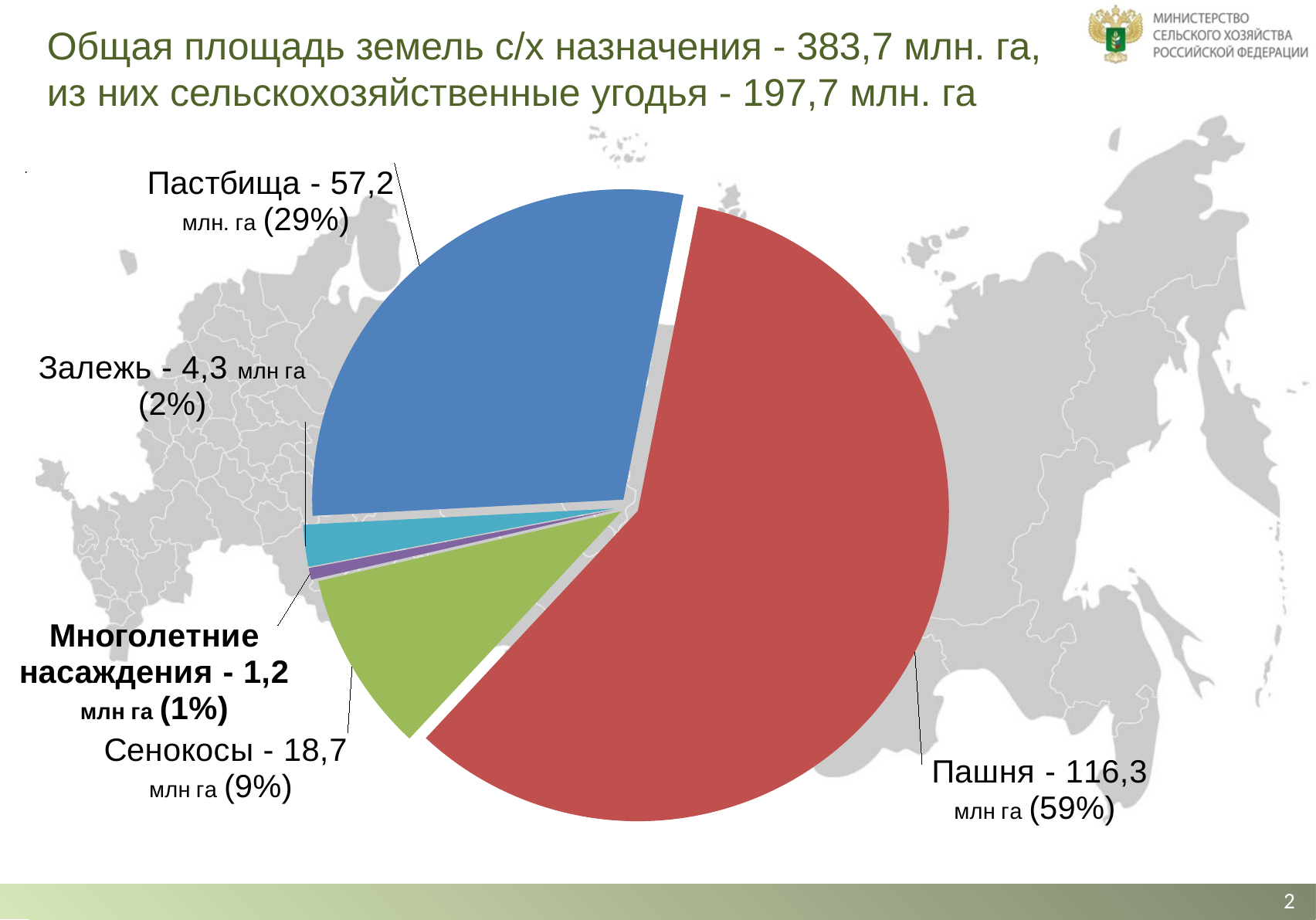
Which is larger, the value for Сенокосы or the value for Залежь? Сенокосы What kind of chart is shown on the slide? Pie chart What is the value for Пастбища? 57,2 млн. га What share of the pie does Пастбища represent? 29% What is the difference between the values for Пашня and Пастбища? 59,1 млн га What is the value for Пашня? 116,3 млн га How many slices does the pie chart have? 5 What is the value for Залежь? 4,3 млн га Which category has the largest slice of the pie? Пашня What share of the pie does Сенокосы represent? 9% What is the value for Сенокосы? 18,7 млн га Which category has the smallest slice of the pie? Многолетние насаждения